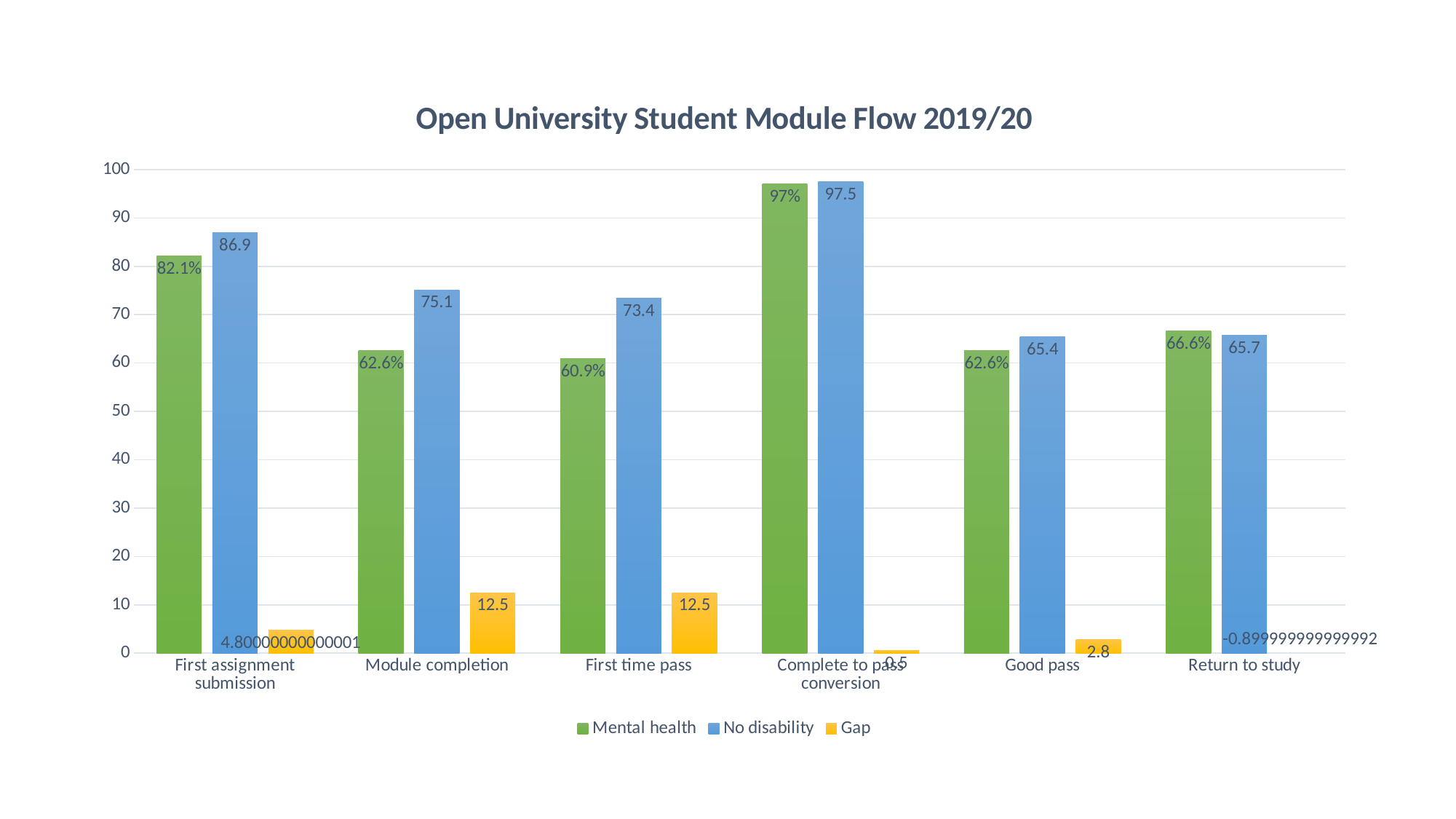
What is the Mental health value for First assignment submission? 82.1% What is the difference between the No disability and Mental health values for Module completion? 12.5 What is the Gap value for Good pass? 2.8 How many categories are shown on the x axis? 6 For First assignment submission, which is larger: the Mental health value or the No disability value? No disability Which category has the lowest Mental health value? First time pass What is the No disability value for Module completion? 75.1 Which category has the highest No disability value? Complete to pass conversion What is the No disability value for Complete to pass conversion? 97.5 How many series does the legend list? 3 What kind of chart is shown on the slide? Bar chart Which category has the highest Mental health value? Complete to pass conversion